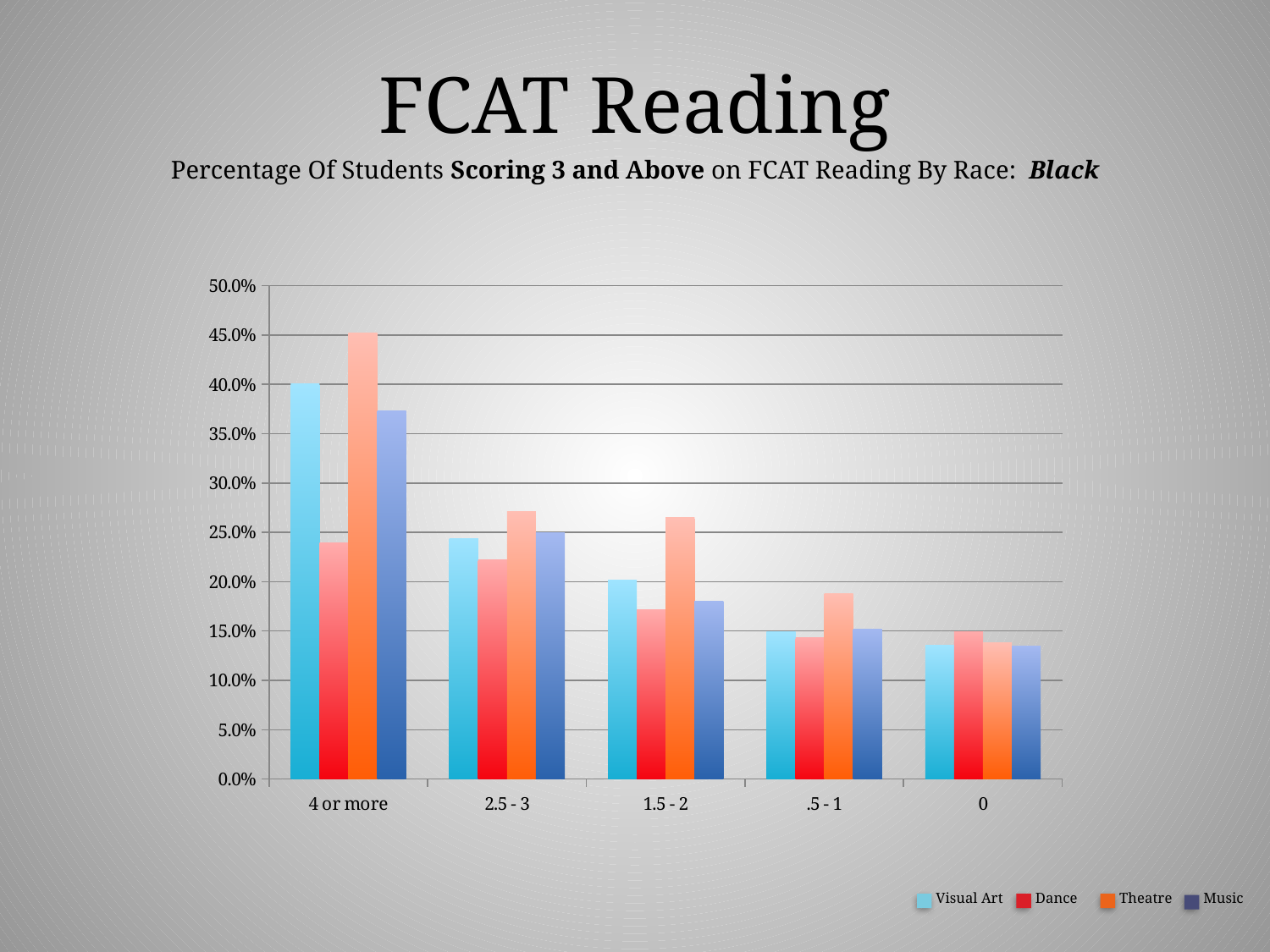
Do the Theatre values rise or fall moving from "4 or more" to "0" along the x axis? fall How many categories are shown on the x axis? 5 Is the Music value for "1.5 - 2" greater or less than 20.0%? less How many series does the legend list? 4 Which series has the lowest value in the "4 or more" category? Dance Is the Dance value for "4 or more" greater or less than 30.0%? less In which category is the Theatre value lowest? 0 What colour represents Theatre in the legend? orange Which series has the highest value in the "4 or more" category? Theatre What kind of chart is shown on the slide? bar chart Is the Visual Art value for "4 or more" greater or less than 35.0%? greater In the "1.5 - 2" category, which is larger: Theatre or Dance? Theatre